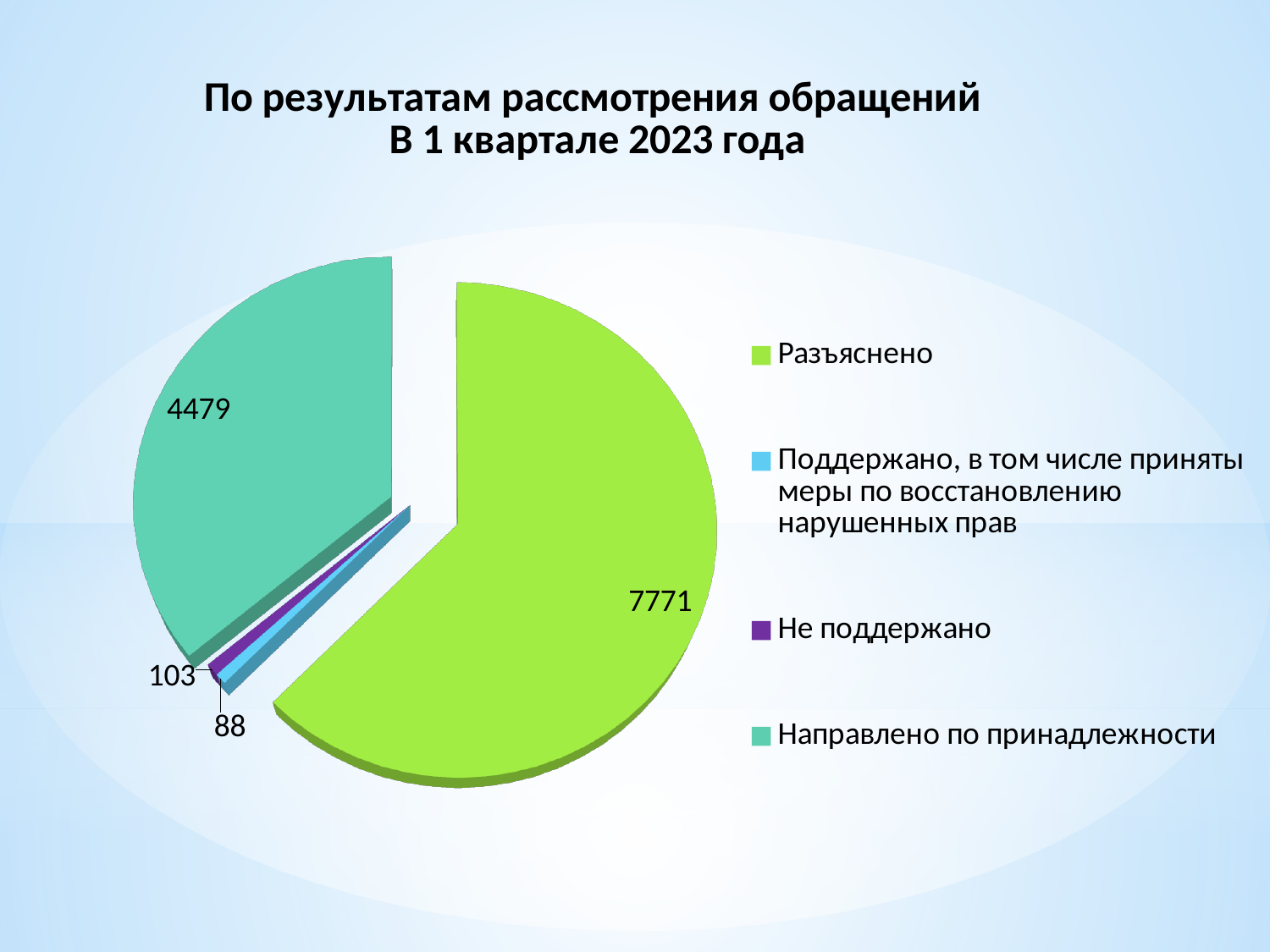
How many categories does the legend list? 4 What is the value for Направлено по принадлежности? 4479 What is the value for Поддержано, в том числе приняты меры по восстановлению нарушенных прав? 88 What is the value for Разъяснено? 7771 Which is larger, Не поддержано or Поддержано? Не поддержано What type of chart is shown on the slide? Pie chart Which category has the largest slice? Разъяснено What is the difference between the values for Не поддержано and Поддержано? 15 What is the value for Не поддержано? 103 What colour is the slice for Направлено по принадлежности? Teal What is the difference between the values for Разъяснено and Направлено по принадлежности? 3292 Which category has the smallest slice? Поддержано, в том числе приняты меры по восстановлению нарушенных прав